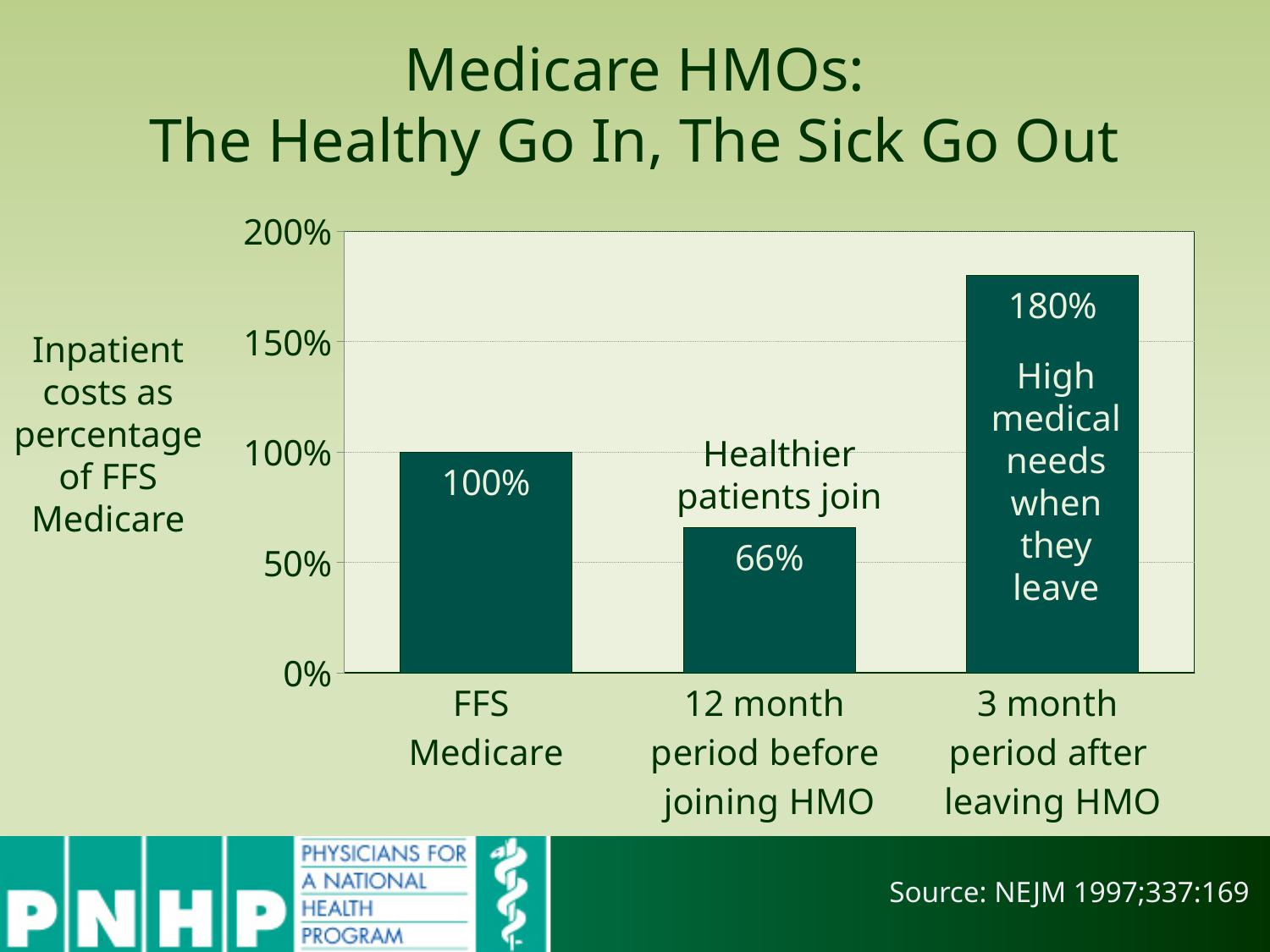
What is the value for the 12 month period before joining HMO? 66% What is the difference between the value for FFS Medicare and the value for the 12 month period before joining HMO? 34% How many categories are shown on the chart? 3 Which is larger, the value for FFS Medicare or the value for the 12 month period before joining HMO? FFS Medicare What kind of chart is shown on the slide? bar chart Is the value for the 3 month period after leaving HMO greater or less than 150%? greater What is the value for FFS Medicare? 100% Which category has the lowest value? 12 month period before joining HMO Which category has the highest value? 3 month period after leaving HMO What is the value for the 3 month period after leaving HMO? 180% What does the y axis of the chart measure, according to the label on the left? Inpatient costs as percentage of FFS Medicare What is the difference between the value for the 3 month period after leaving HMO and the value for FFS Medicare? 80%